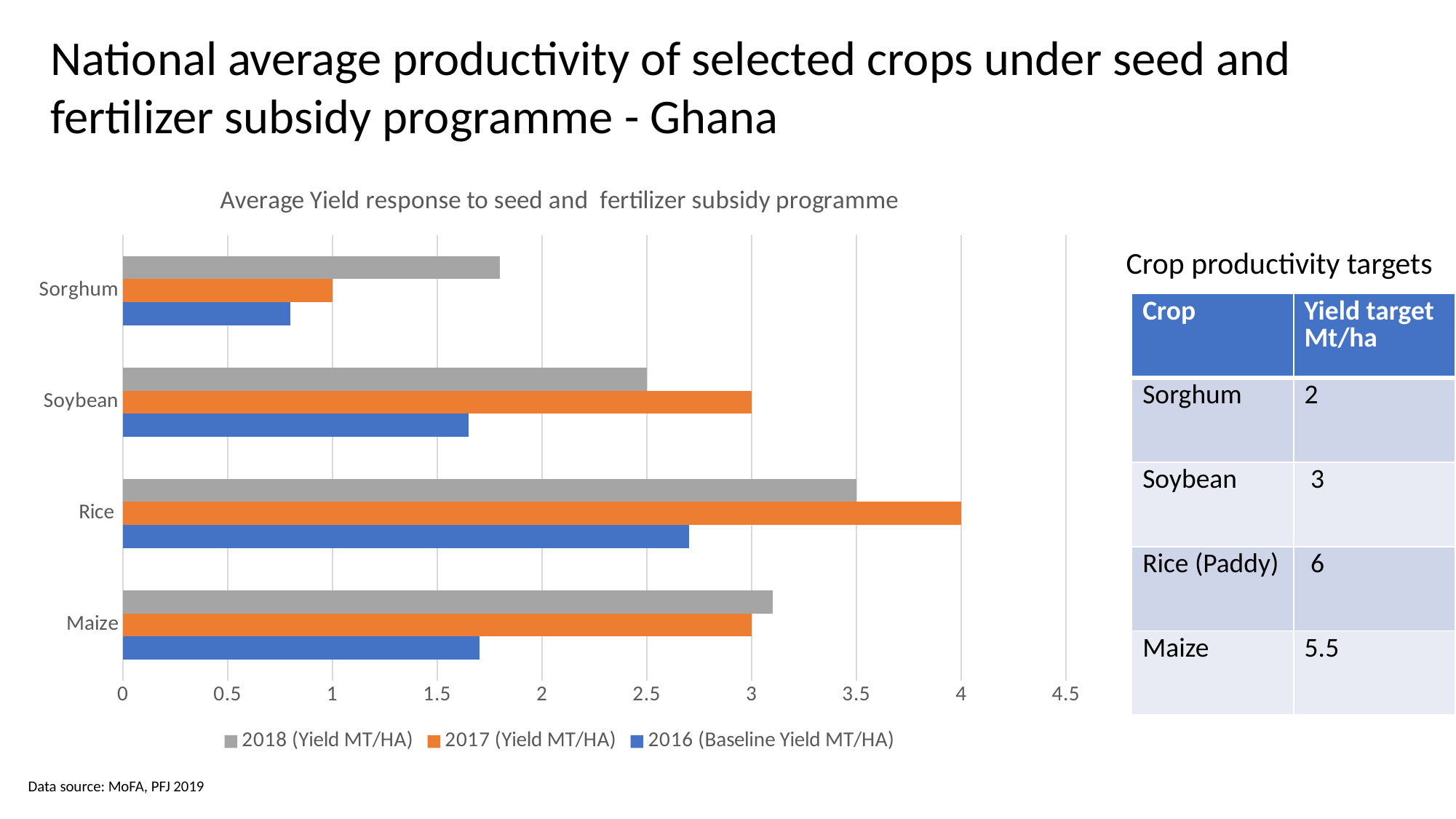
What kind of chart is shown on the slide? Bar chart Is the 2016 baseline yield for Maize greater or less than 2? less Which crop has the lowest 2016 baseline yield? Sorghum For Rice, which is larger: the 2017 yield or the 2018 yield? 2017 yield What is the 2018 yield (MT/HA) for Soybean? 2.5 How many crops are shown on the chart? 4 What is the difference between the 2017 yields of Rice and Soybean? 1 How many series does the legend list? 3 What is the 2018 yield (MT/HA) for Rice? 3.5 Which crop has the highest 2017 yield? Rice What is the 2017 yield (MT/HA) for Sorghum? 1 What is the 2017 yield (MT/HA) for Rice? 4